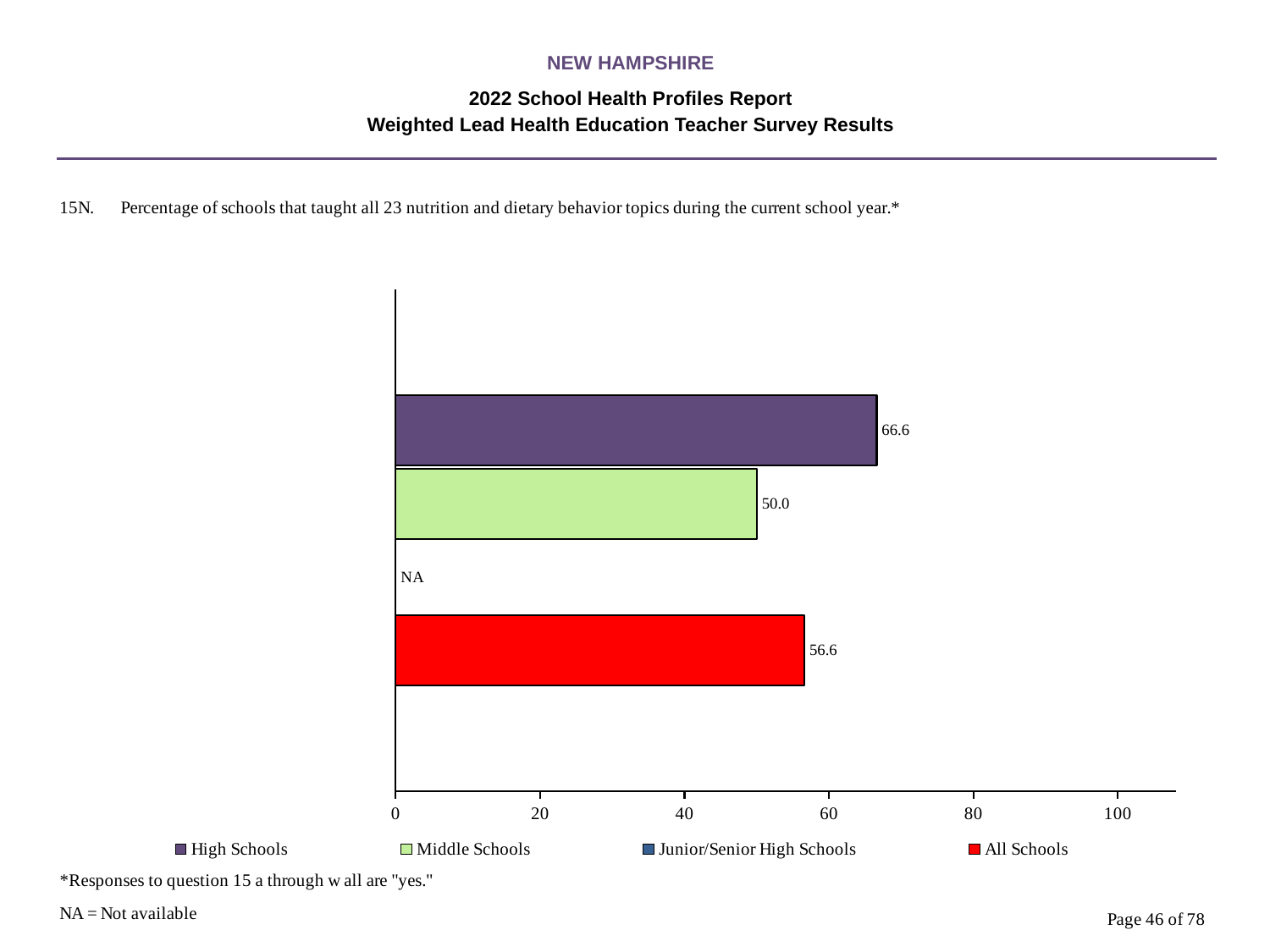
What is the value for Middle Schools? 50.0 Is the value for High Schools greater or less than 60? greater Which is larger, the value for Middle Schools or the value for All Schools? All Schools What is the value for All Schools? 56.6 Which school type has the highest value? High Schools What is the difference between the High Schools value and the Middle Schools value? 16.6 How many series does the legend list? 4 Among the school types with a plotted value, which has the lowest? Middle Schools What is shown for Junior/Senior High Schools? NA What kind of chart is shown on the slide? Bar chart What is the value for High Schools? 66.6 What is the difference between the High Schools value and the All Schools value? 10.0